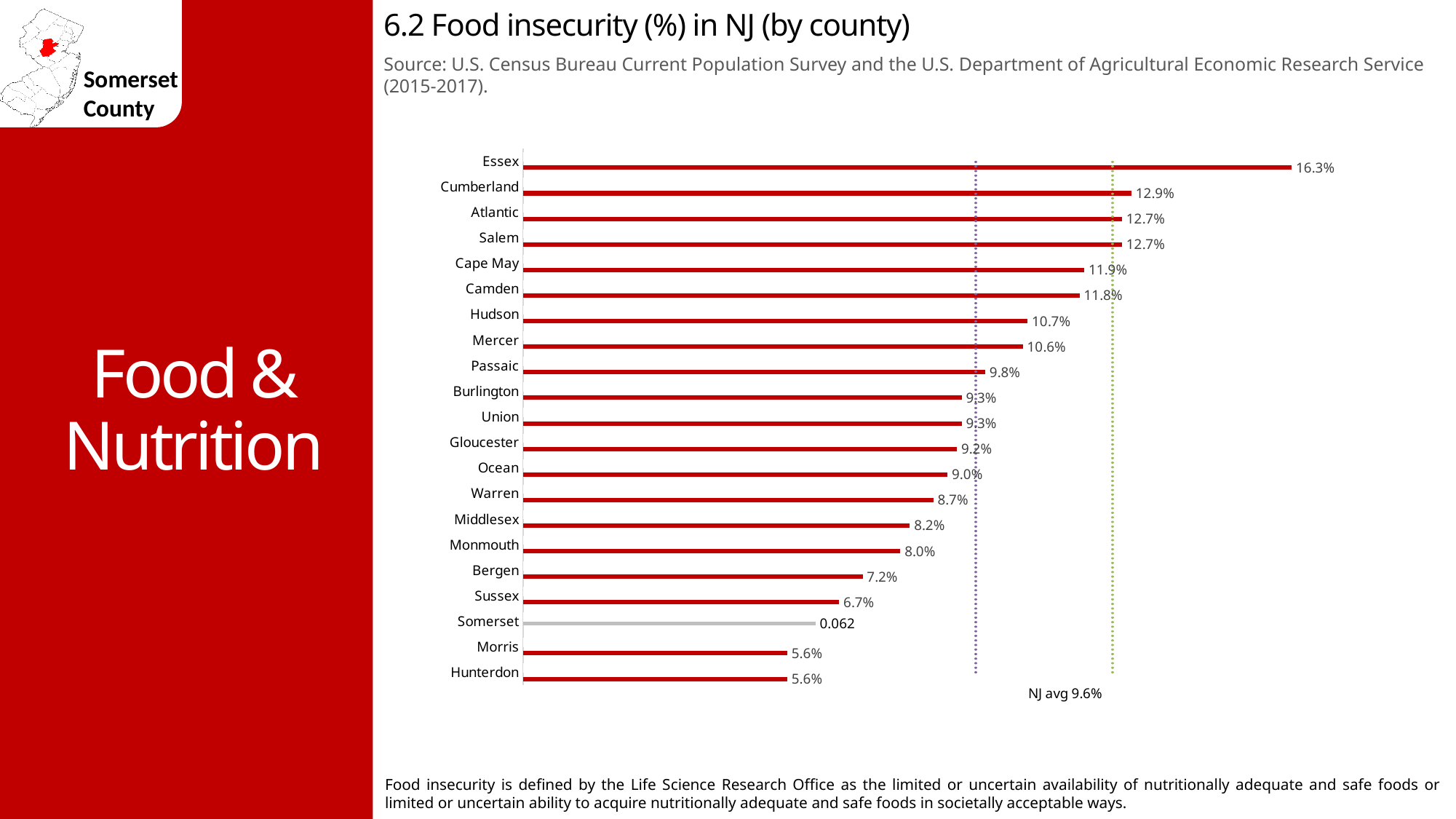
What NJ average value is labelled on the chart? NJ avg 9.6% What type of chart is shown on the slide? bar chart What value is printed next to the Somerset bar? 0.062 Which county has the highest food insecurity value? Essex What is the difference between the values for Essex and Cumberland? 3.4 percentage points Which county's bar is drawn in grey instead of red? Somerset What is the food insecurity value for Mercer? 10.6% What is the food insecurity value for Bergen? 7.2% How many counties are listed in the chart? 21 What is the difference between the values for Bergen and Sussex? 0.5 percentage points What is the food insecurity value for Essex? 16.3% Which has a higher food insecurity value, Hudson or Monmouth? Hudson